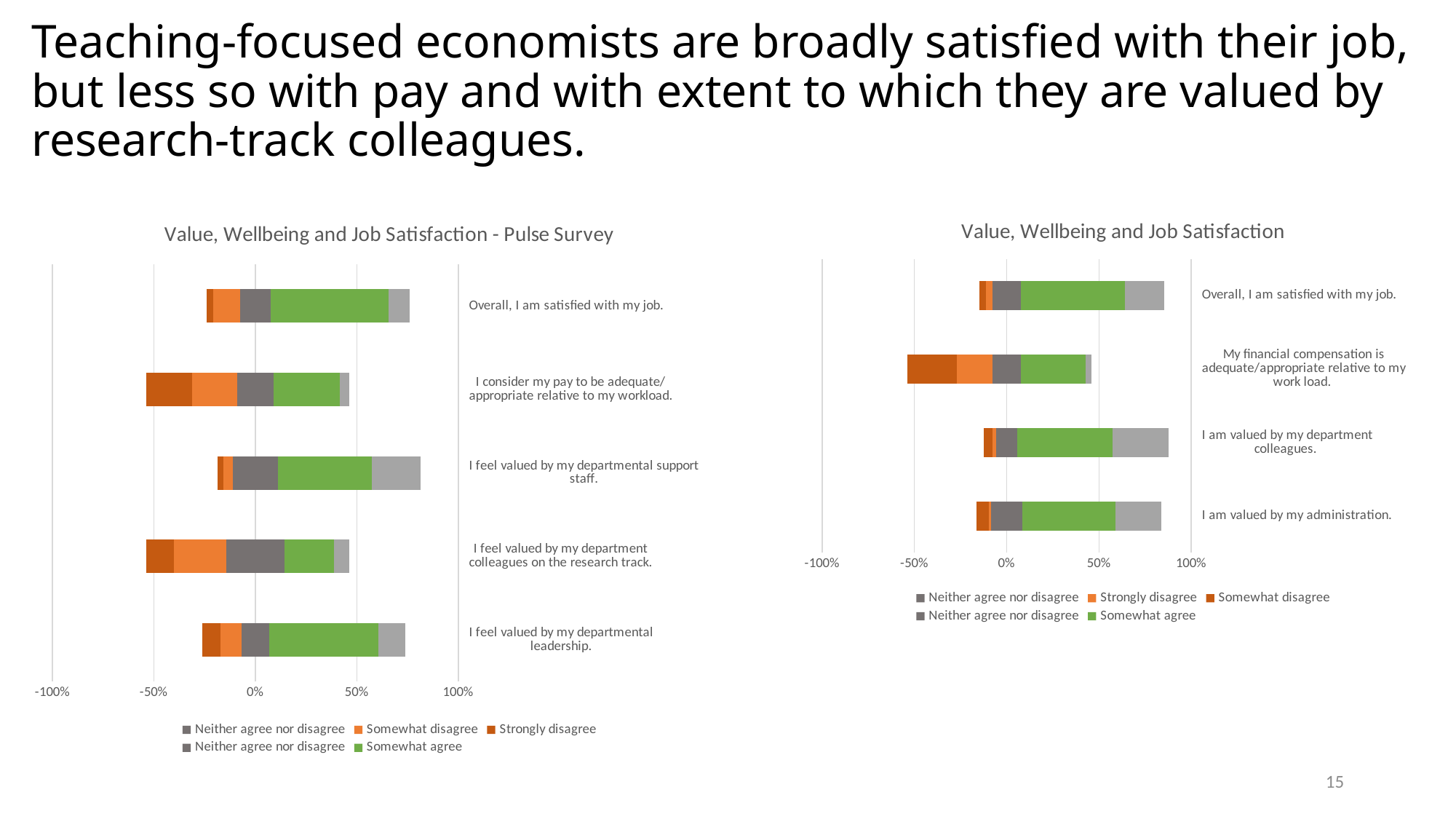
In the left chart (Pulse Survey), which statement's bar extends furthest to the right (highest agreement)? I feel valued by my departmental support staff. In the right chart ('Value, Wellbeing and Job Satisfaction'), which statement's bar extends furthest to the left (most disagreement)? My financial compensation is adequate/appropriate relative to my work load. In the left chart (Pulse Survey), is the leftmost extent of the bar for 'I consider my pay to be adequate/appropriate relative to my workload' greater or less than -50%? less How many survey statements (categories) are plotted in the left chart, 'Value, Wellbeing and Job Satisfaction - Pulse Survey'? 5 What kind of chart is the 'Value, Wellbeing and Job Satisfaction - Pulse Survey' chart on the left? Stacked bar chart How many survey statements (categories) are plotted in the right chart, 'Value, Wellbeing and Job Satisfaction'? 4 In the left chart, which colour represents 'Somewhat agree'? Green How many entries does the legend of the right chart, 'Value, Wellbeing and Job Satisfaction', list? 5 In the right chart ('Value, Wellbeing and Job Satisfaction'), is the rightmost extent of the bar for 'I am valued by my department colleagues' greater or less than 50%? greater What is the title of the chart on the left of the slide? Value, Wellbeing and Job Satisfaction - Pulse Survey In the right chart ('Value, Wellbeing and Job Satisfaction'), which statement's bar extends least far to the right? My financial compensation is adequate/appropriate relative to my work load. In the left chart (Pulse Survey), is the rightmost extent of the bar for 'I feel valued by my departmental support staff' greater or less than 50%? greater